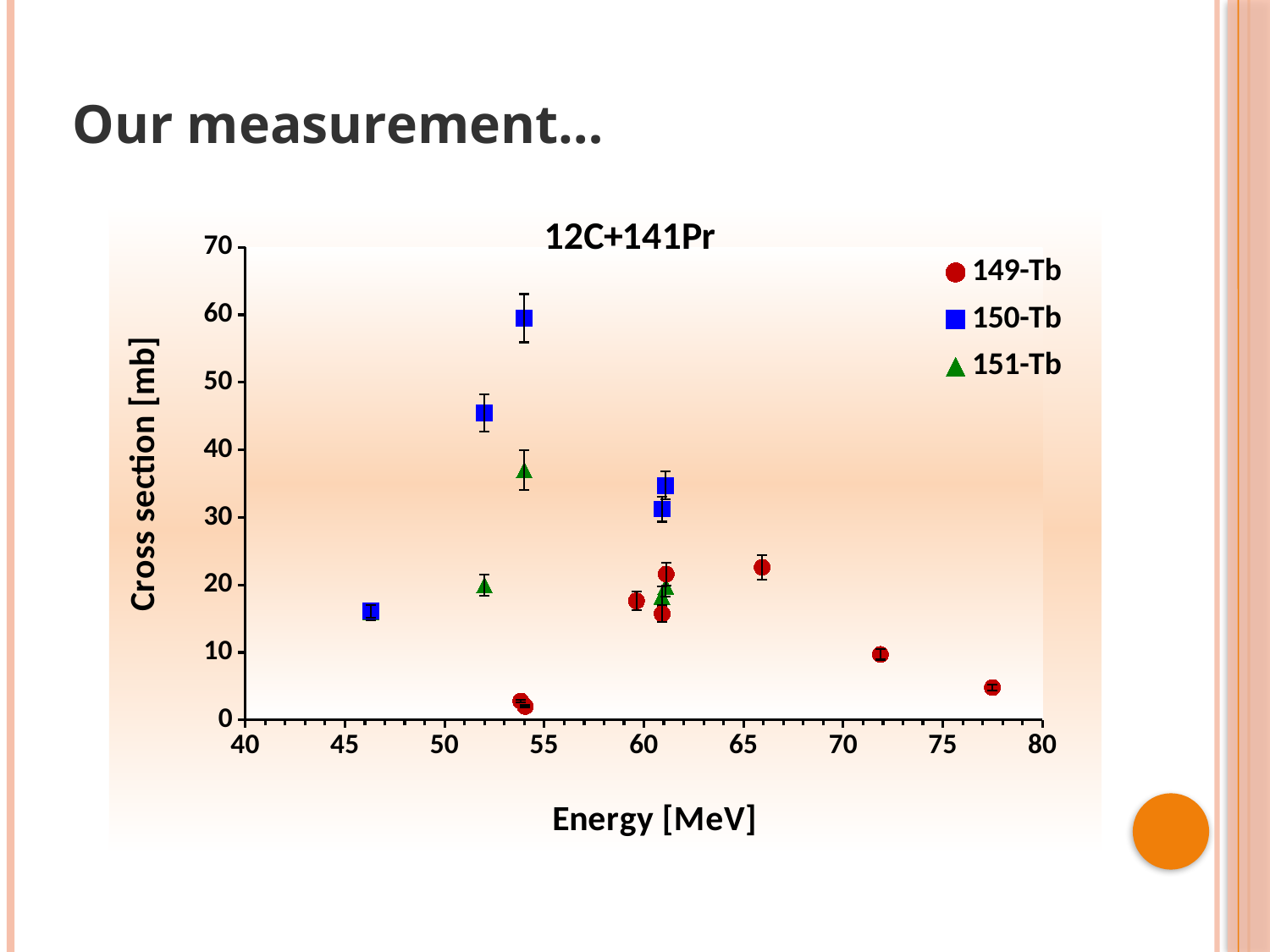
Do the 149-Tb values rise or fall as energy increases from about 66 MeV to about 77 MeV? fall Is the 149-Tb value at the highest energy (around 77 MeV) greater or less than 10 mb? less How many series does the legend list? 3 What kind of chart is shown on the slide? scatter chart Is the 150-Tb value at the lowest energy (around 46 MeV) greater or less than 10 mb? greater Is the highest 150-Tb value greater or less than 50 mb? greater Which series has the highest cross section value on the chart? 150-Tb Which series has the lowest cross section value on the chart? 149-Tb What is the title of the chart? 12C+141Pr What is the label of the y axis? Cross section [mb]